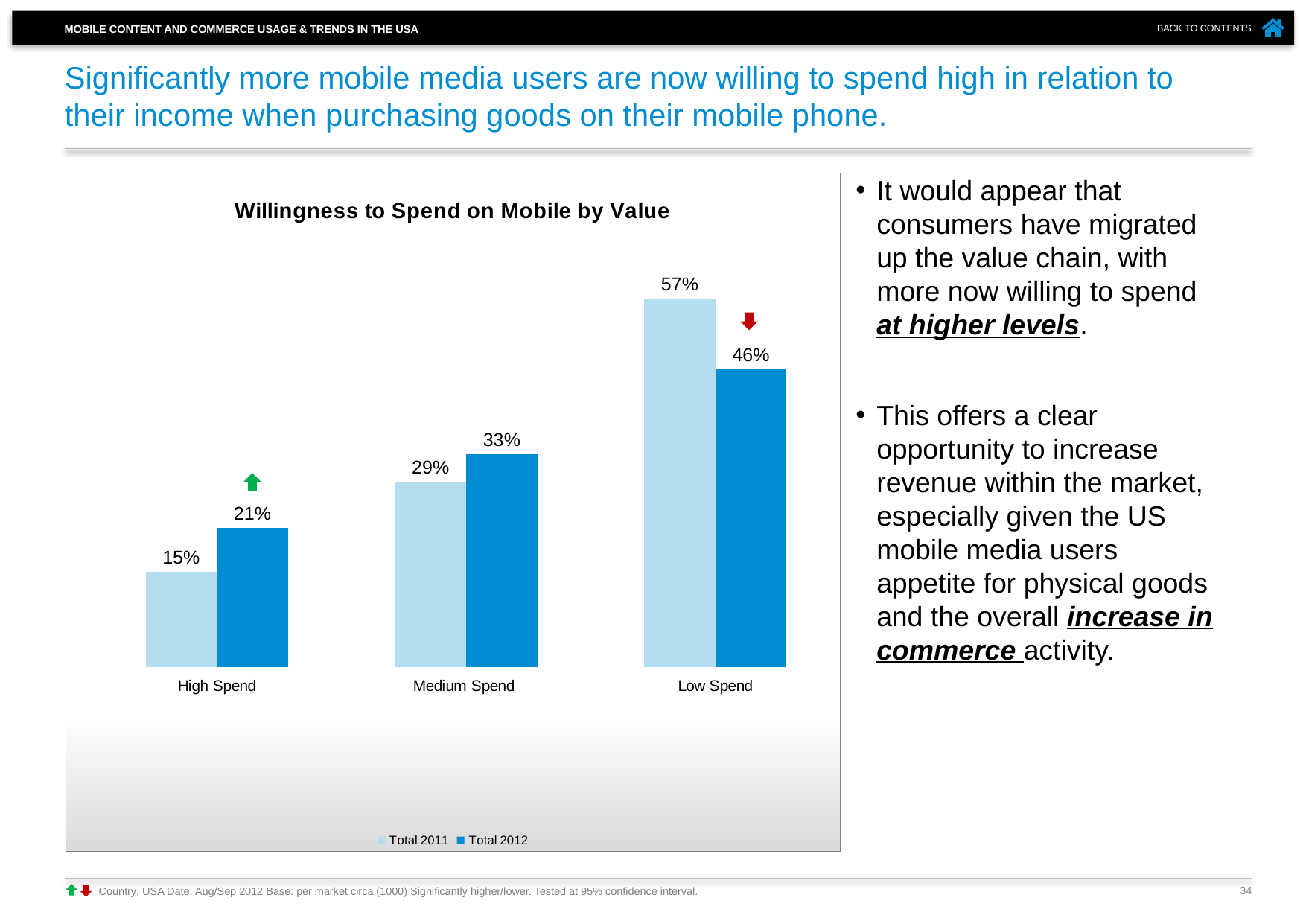
Which category has the lowest Total 2011 value? High Spend What is the difference between the Total 2011 and Total 2012 values for Low Spend? 11% What is the Total 2011 value for Low Spend? 57% Which category has the highest Total 2012 value? Low Spend Which is larger for Medium Spend, Total 2011 or Total 2012? Total 2012 What is the Total 2012 value for High Spend? 21% How many series does the legend list? 2 What is the title of the chart? Willingness to Spend on Mobile by Value What kind of chart is shown? Bar chart What is the Total 2011 value for Medium Spend? 29% How many categories are shown on the x axis? 3 What is the difference between the Total 2012 and Total 2011 values for High Spend? 6%